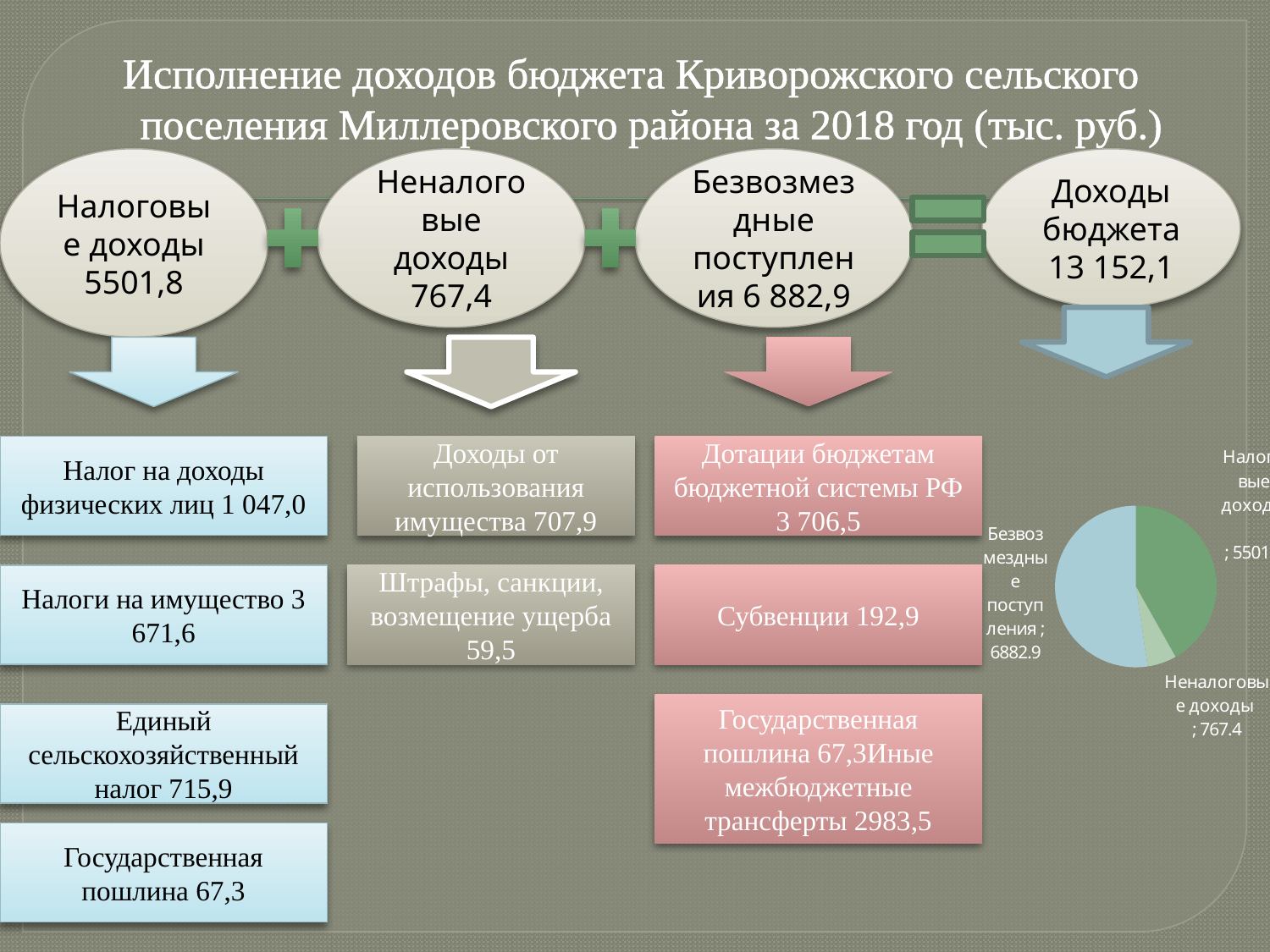
What colour is the Безвозмездные поступления slice in the pie chart? light blue Which slice of the pie chart is the largest? Безвозмездные поступления In the pie chart, what value is labelled for Безвозмездные поступления? 6882.9 Which slice of the pie chart is the smallest? Неналоговые доходы What kind of chart is shown at the bottom right of the slide? pie chart In the pie chart, what is the difference between the values for Безвозмездные поступления and Неналоговые доходы? 6115.5 How many slices does the pie chart at the bottom right of the slide have? 3 In the pie chart, what value is labelled for Неналоговые доходы? 767.4 In the pie chart, which is larger: Безвозмездные поступления or Неналоговые доходы? Безвозмездные поступления What colour is the Налоговые доходы slice in the pie chart? green In the pie chart, which is larger: Налоговые доходы or Неналоговые доходы? Налоговые доходы